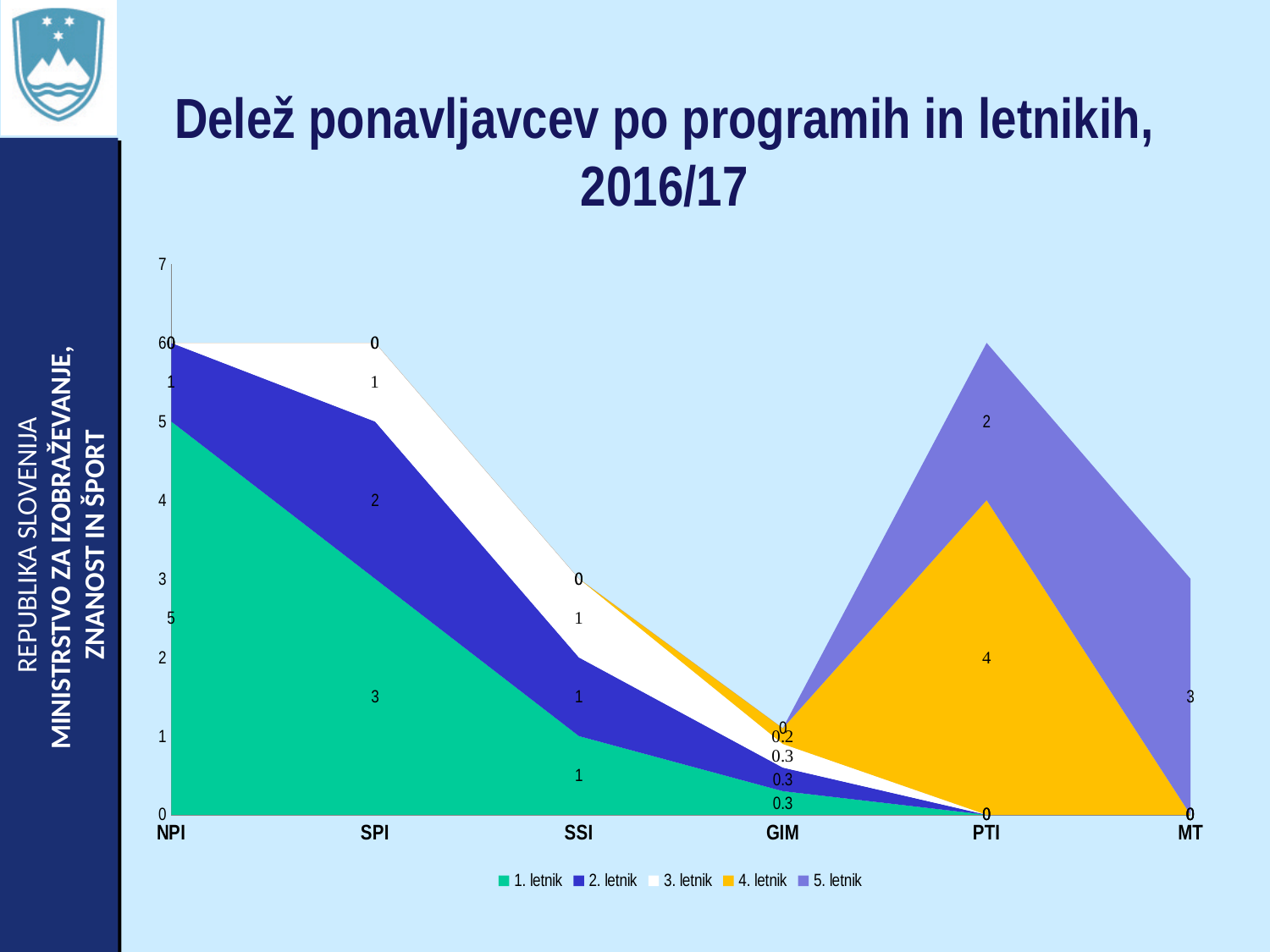
What is the value for 1. letnik at NPI? 5 What kind of chart is shown on the slide? area chart Which category has the highest value for 1. letnik? NPI What is the value for 5. letnik at MT? 3 What is the value for 4. letnik at PTI? 4 What is the value for 5. letnik at PTI? 2 How many categories are shown along the x axis? 6 What is the value for 2. letnik at SPI? 2 What is the difference between the 1. letnik values at NPI and SPI? 2 How many series does the legend list? 5 At PTI, which is larger: the value for 4. letnik or the value for 5. letnik? 4. letnik What is the value for 1. letnik at SPI? 3